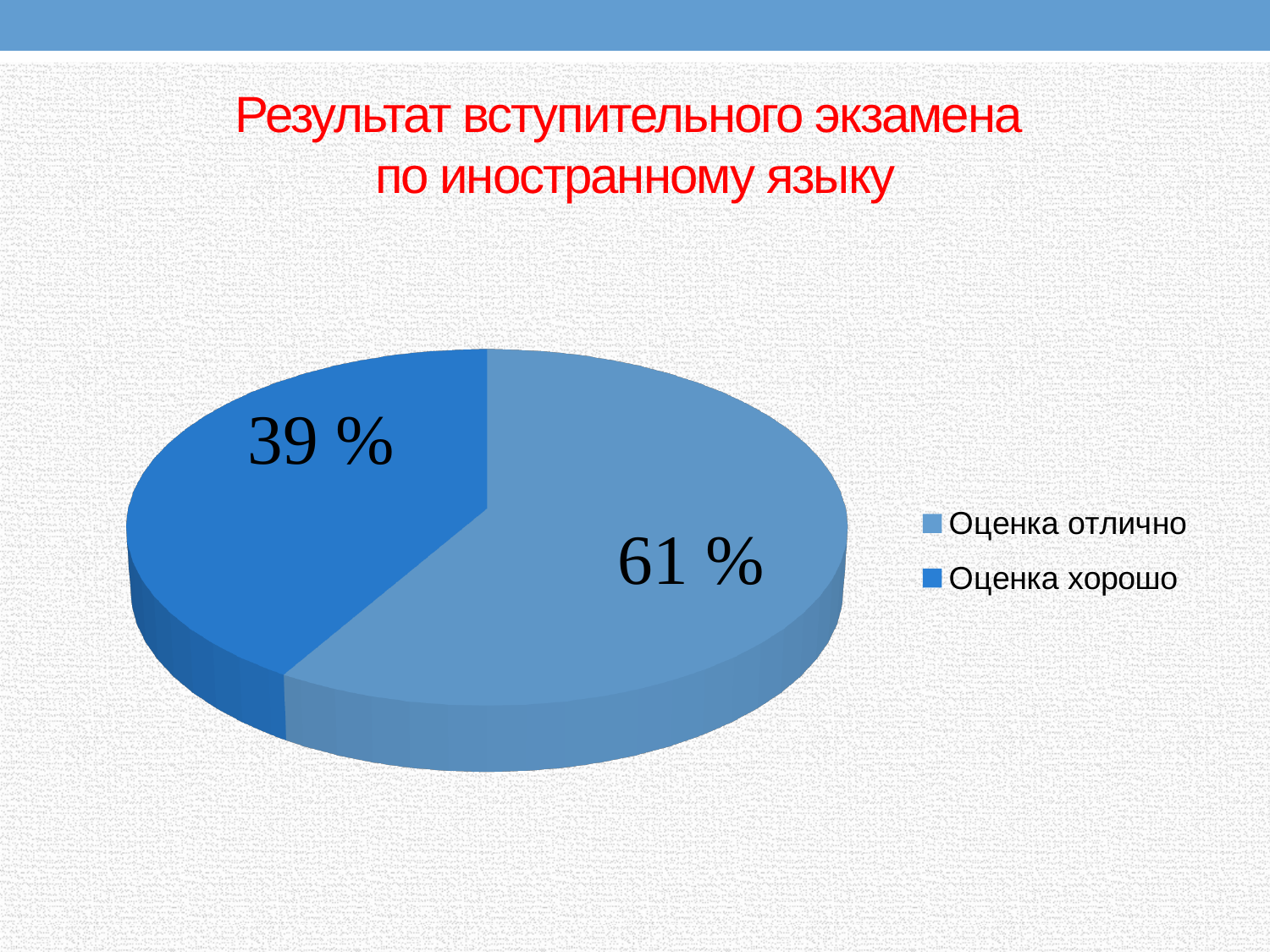
Which legend entry is shown in the darker blue colour? Оценка хорошо How many entries does the legend list? 2 Which category has the smallest slice of the pie? Оценка хорошо What is the difference in percentage points between "Оценка отлично" and "Оценка хорошо"? 22 Which is larger: the slice for "Оценка отлично" or the slice for "Оценка хорошо"? Оценка отлично What share of the pie does "Оценка хорошо" represent? 39 % What share of the pie does "Оценка отлично" represent? 61 % What is the title of the slide containing the chart? Результат вступительного экзамена по иностранному языку How many categories does the pie chart show? 2 Which category has the largest slice of the pie? Оценка отлично What type of chart is shown on the slide? Pie chart